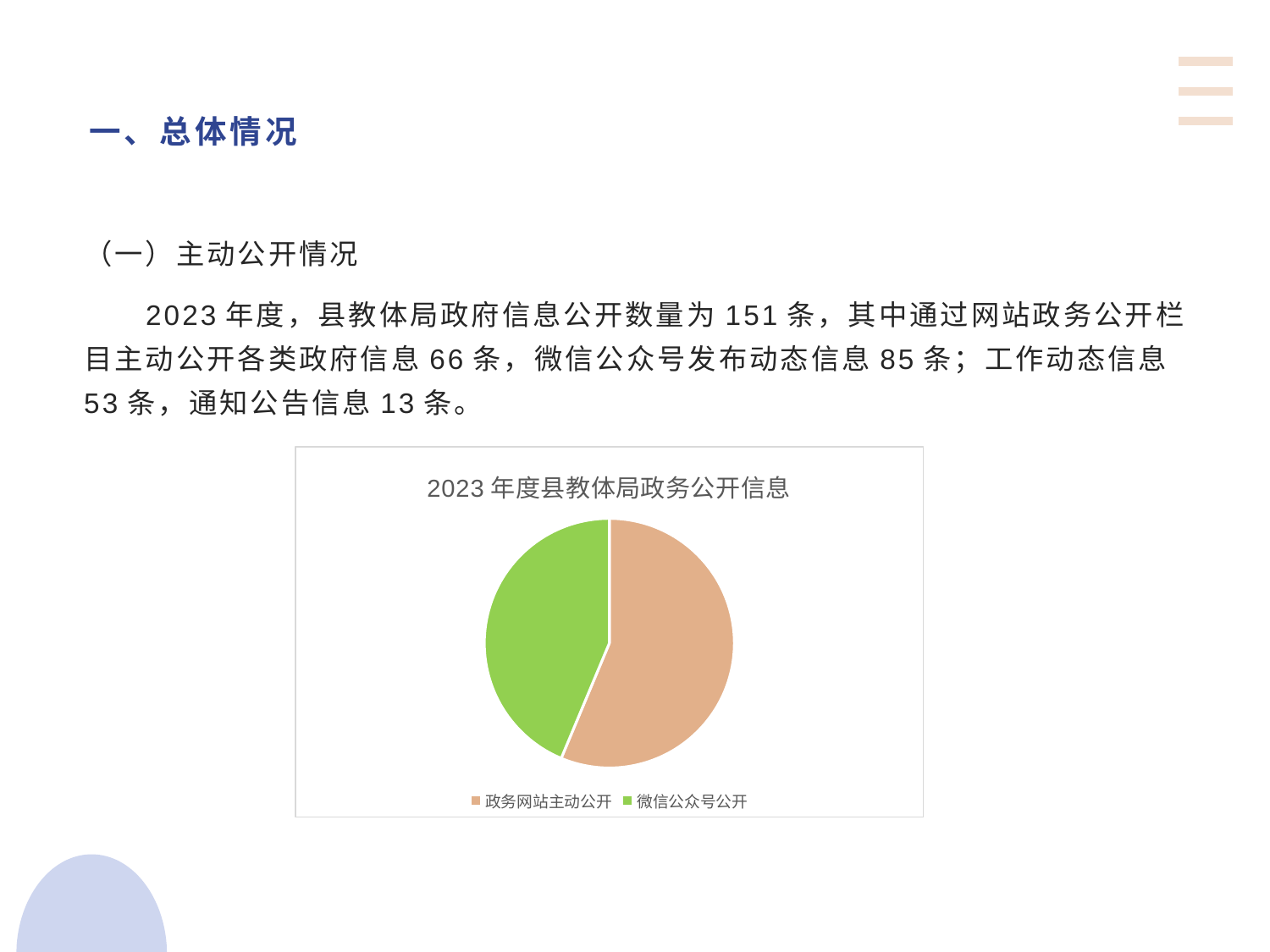
How many slices does the pie chart have? 2 What kind of chart is shown on the slide? Pie chart Which colour represents 微信公众号公开 in the pie chart? Green Does the 政务网站主动公开 slice take up more or less than half of the pie? More Which category has the largest slice of the pie? 政务网站主动公开 What is the title of the chart? 2023 年度县教体局政务公开信息 How many entries does the chart legend list? 2 Which category has the smallest slice of the pie? 微信公众号公开 Which slice is larger, 政务网站主动公开 or 微信公众号公开? 政务网站主动公开